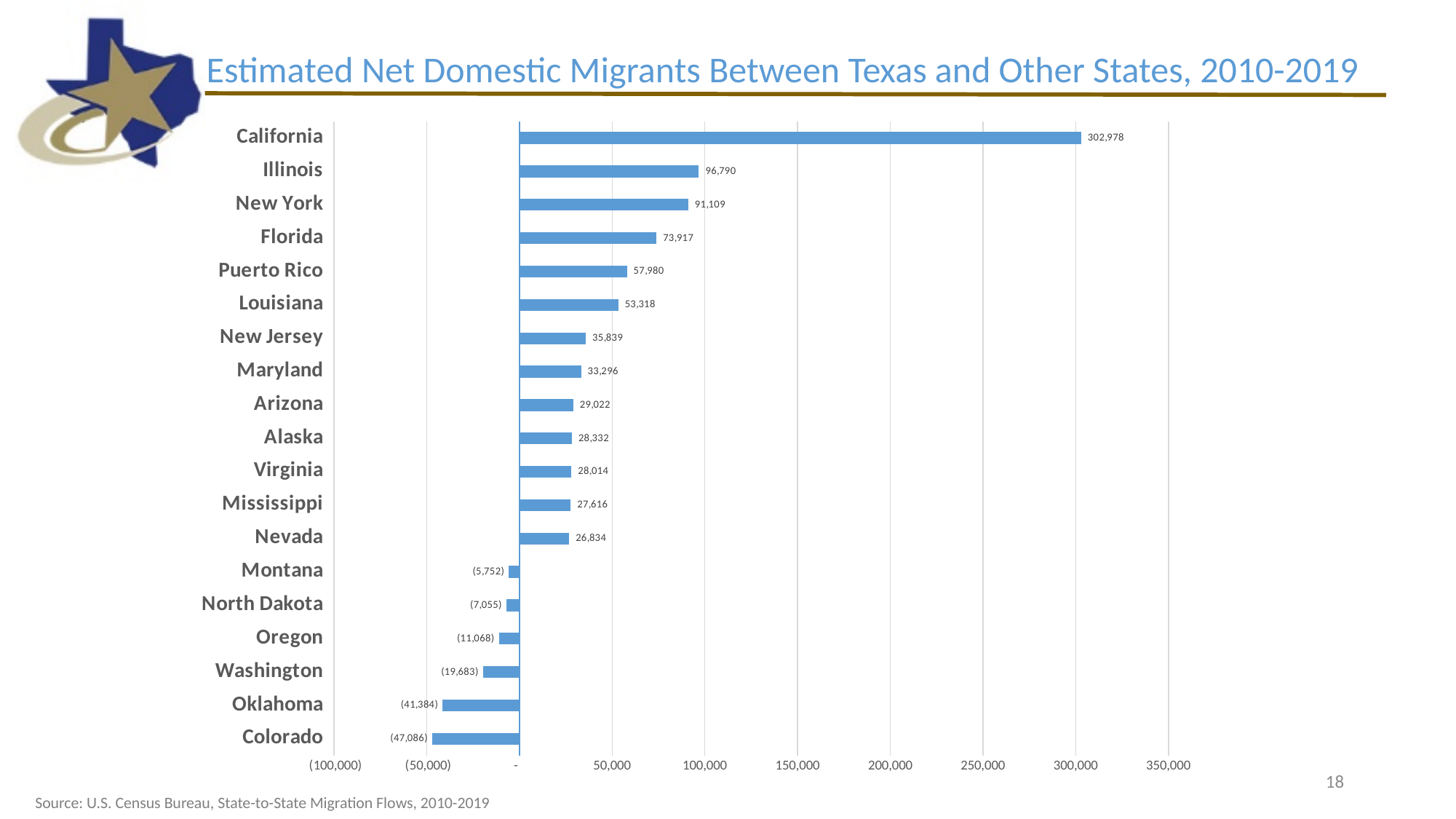
What is the difference between the values for Florida and Puerto Rico? 15,937 Which state has the highest value? California What is the value for Puerto Rico? 57,980 How many states or territories are shown in the chart? 19 What is the value for Colorado? (47,086) What is the value for Washington? (19,683) What is the value for California? 302,978 Which state has the lowest value? Colorado What is the difference between the values for California and Illinois? 206,188 What kind of chart is shown on the slide? Bar chart Which has the larger value, Puerto Rico or Louisiana? Puerto Rico Is the value for New Jersey greater or less than 50,000? less